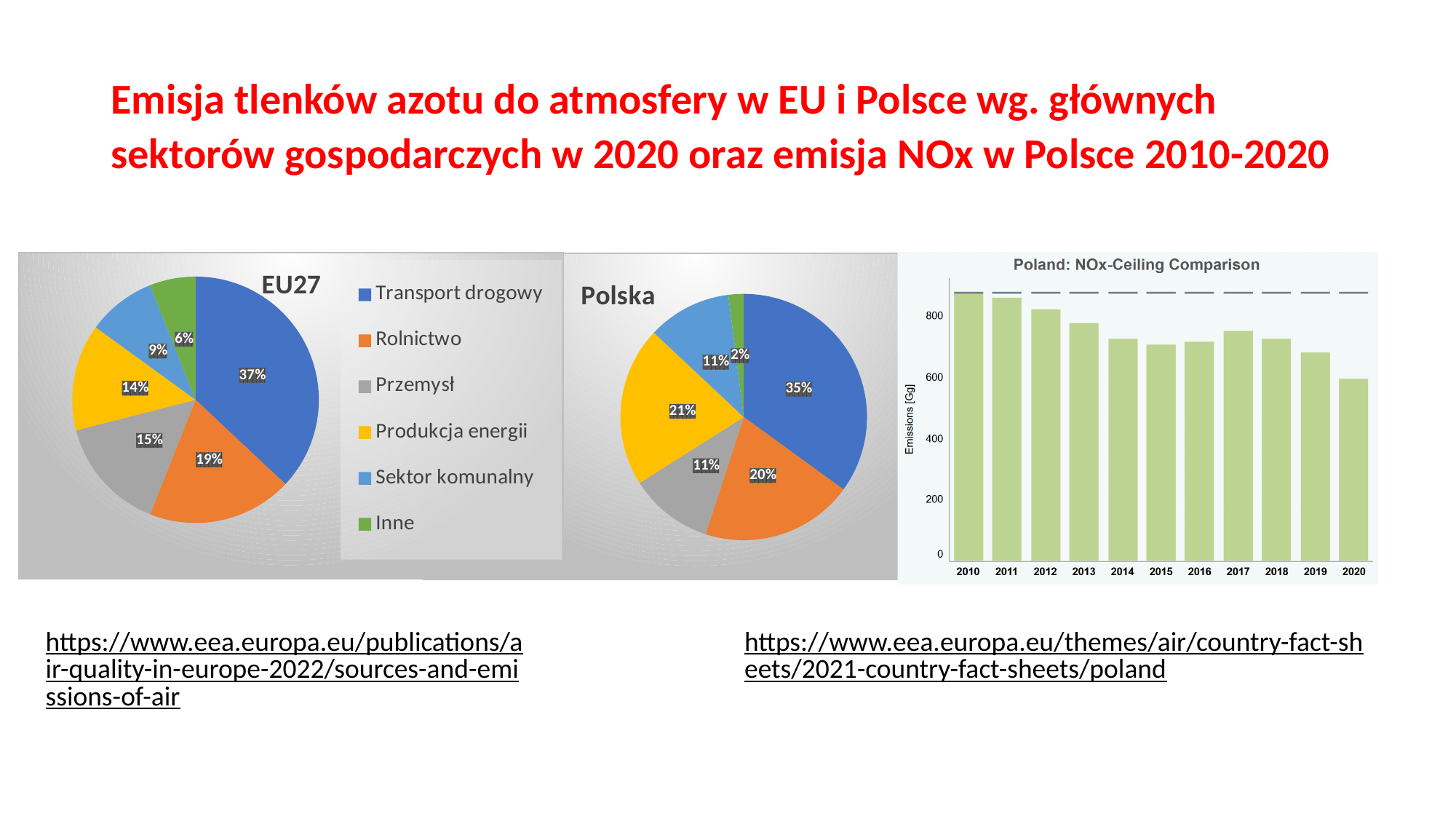
How many sectors does the legend of the pie charts list? 6 In the Poland: NOx-Ceiling Comparison chart, how many years are shown on the x axis? 11 In the EU27 pie chart, what share does Transport drogowy have? 37% In the Polska pie chart, which is larger: the share of Produkcja energii or the share of Rolnictwo? Produkcja energii What kind of chart is the Poland: NOx-Ceiling Comparison chart? bar chart In the Poland: NOx-Ceiling Comparison chart, do emissions generally rise or fall from 2010 to 2020? fall In the Polska pie chart, what share does Inne have? 2% In the Polska pie chart, what share does Produkcja energii have? 21% In the EU27 pie chart, what is the difference between the shares of Rolnictwo and Sektor komunalny? 10% In the EU27 pie chart, which sector has the smallest share? Inne In the Polska pie chart, which sector has the largest share? Transport drogowy